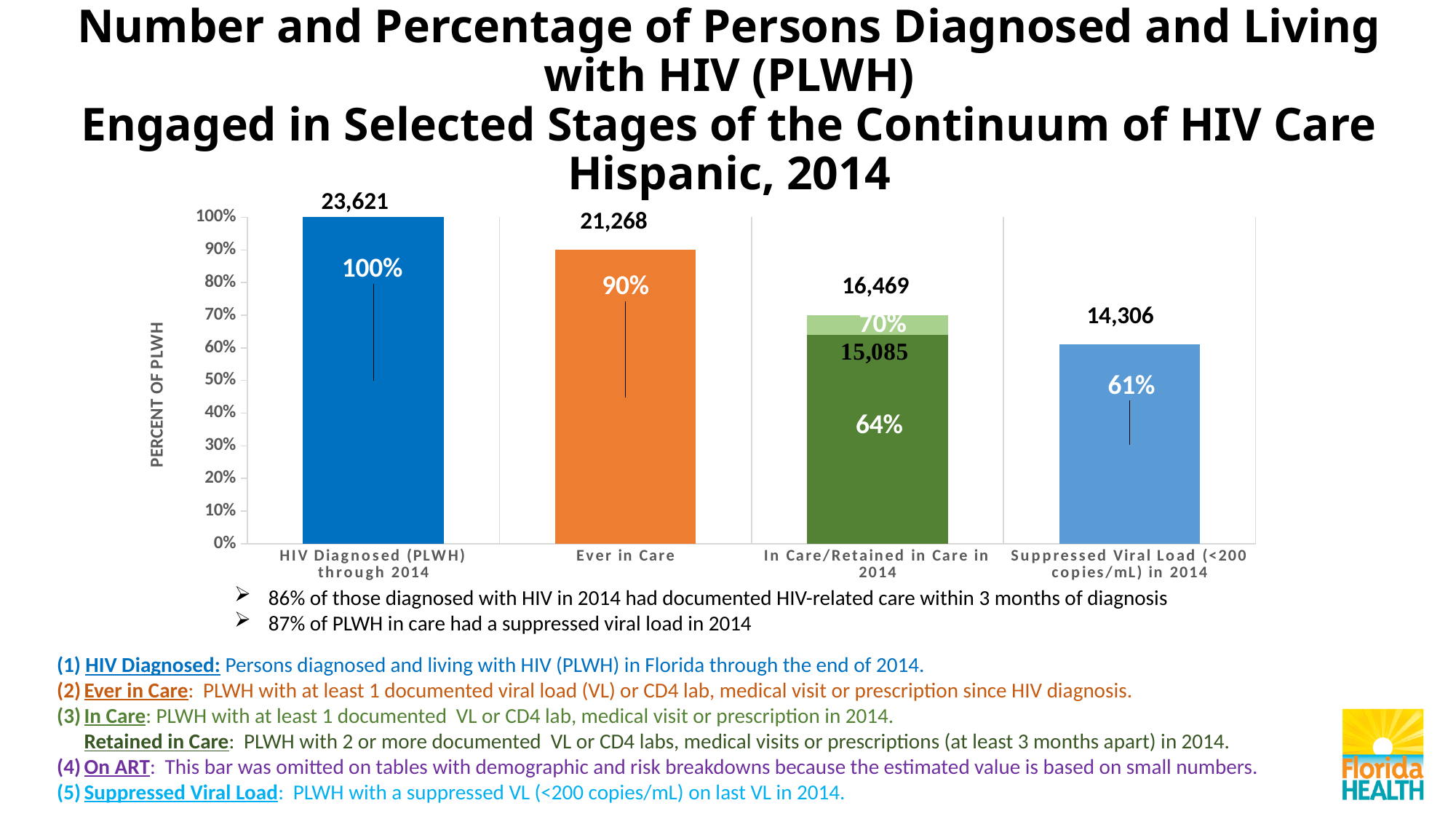
What kind of chart is shown on the slide? Bar chart What is the difference in number of persons between 'HIV Diagnosed (PLWH) through 2014' and 'Ever in Care'? 2,353 How many persons are shown for the 'HIV Diagnosed (PLWH) through 2014' bar? 23,621 Which is larger, the percentage for 'Ever in Care' or the percentage for 'Suppressed Viral Load (<200 copies/mL) in 2014'? Ever in Care How many categories are shown on the x axis of the chart? 4 What percentage of PLWH is shown for 'Ever in Care'? 90% What percentage is shown for 'Suppressed Viral Load (<200 copies/mL) in 2014'? 61% Do the percentages rise or fall moving from left to right across the chart? Fall What number is shown at the top of the 'In Care/Retained in Care in 2014' bar? 16,469 Which category has the highest number of persons? HIV Diagnosed (PLWH) through 2014 What number is shown for Retained in Care within the 'In Care/Retained in Care in 2014' bar? 15,085 Which category has the lowest percentage of PLWH? Suppressed Viral Load (<200 copies/mL) in 2014